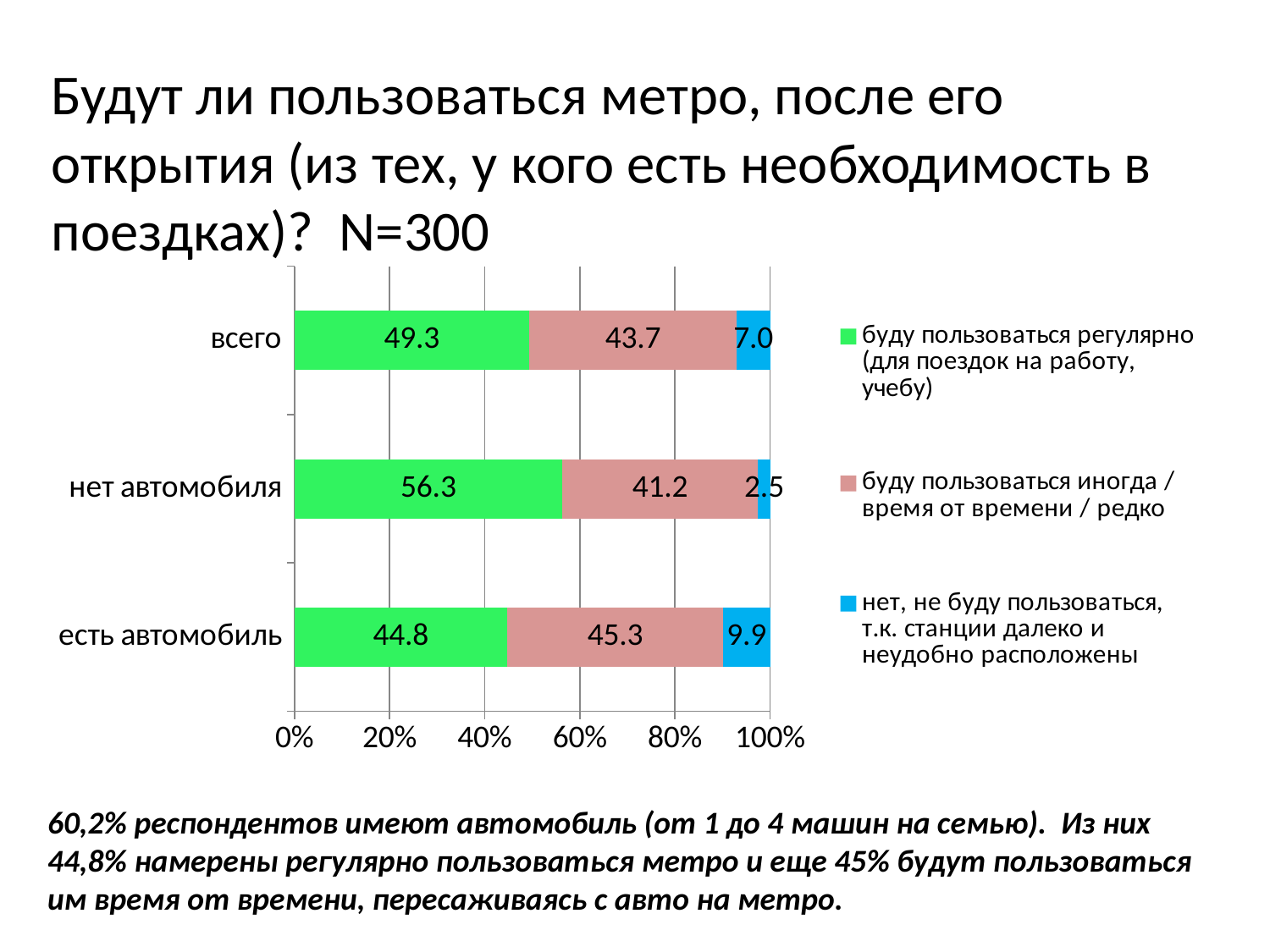
What colour represents the series 'нет, не буду пользоваться, т.к. станции далеко и неудобно расположены'? blue Which category has the highest value for 'буду пользоваться регулярно'? нет автомобиля What is the difference between the 'буду пользоваться регулярно' values for 'нет автомобиля' and 'есть автомобиль'? 11.5 How many series does the legend list? 3 How many categories are shown on the chart? 3 Which is larger in the 'есть автомобиль' category: 'буду пользоваться регулярно' or 'буду пользоваться иногда / время от времени / редко'? буду пользоваться иногда / время от времени / редко What is the value for 'нет, не буду пользоваться' in the 'есть автомобиль' category? 9.9 What is the sample size (N) stated in the chart title? N=300 Which category has the lowest value for 'нет, не буду пользоваться'? нет автомобиля What is the value for 'буду пользоваться иногда / время от времени / редко' in the 'нет автомобиля' category? 41.2 What is the value for 'буду пользоваться регулярно' in the 'всего' category? 49.3 What type of chart is shown on the slide? stacked bar chart